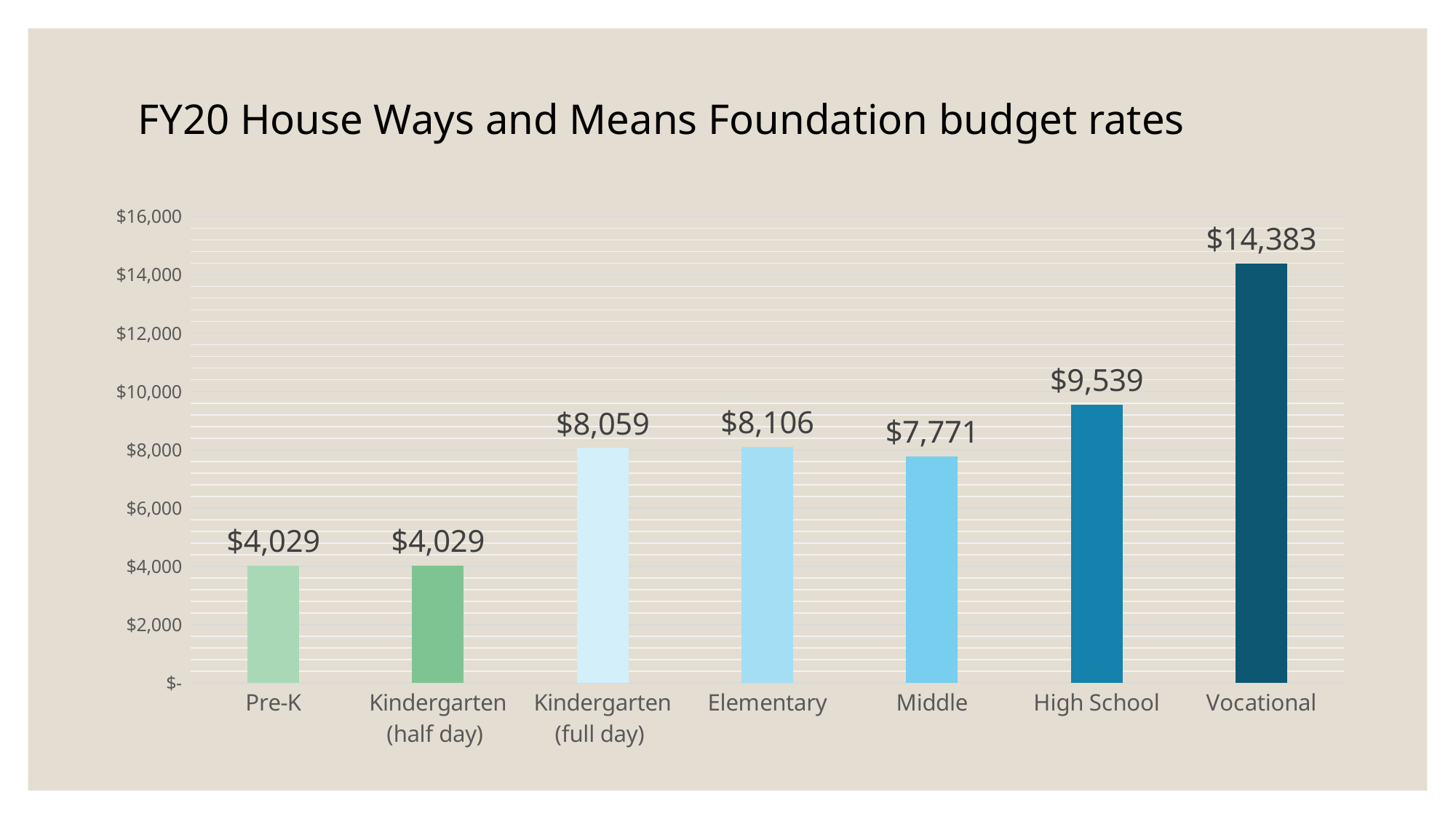
Which category has the highest foundation budget rate? Vocational Do the Pre-K and Kindergarten (half day) bars have the same value? Yes, $4,029 What is the title of the chart? FY20 House Ways and Means Foundation budget rates What is the difference between the High School rate and the Middle rate? $1,768 How many categories are shown on the chart? 7 What is the FY20 foundation budget rate for Kindergarten (full day)? $8,059 What is the FY20 foundation budget rate for Middle? $7,771 Which is larger, the rate for Elementary or the rate for Middle? Elementary What is the difference between the Vocational rate and the Pre-K rate? $10,354 Is the value for High School greater or less than $10,000? less What kind of chart is shown on the slide? Bar chart What is the FY20 foundation budget rate for Vocational? $14,383